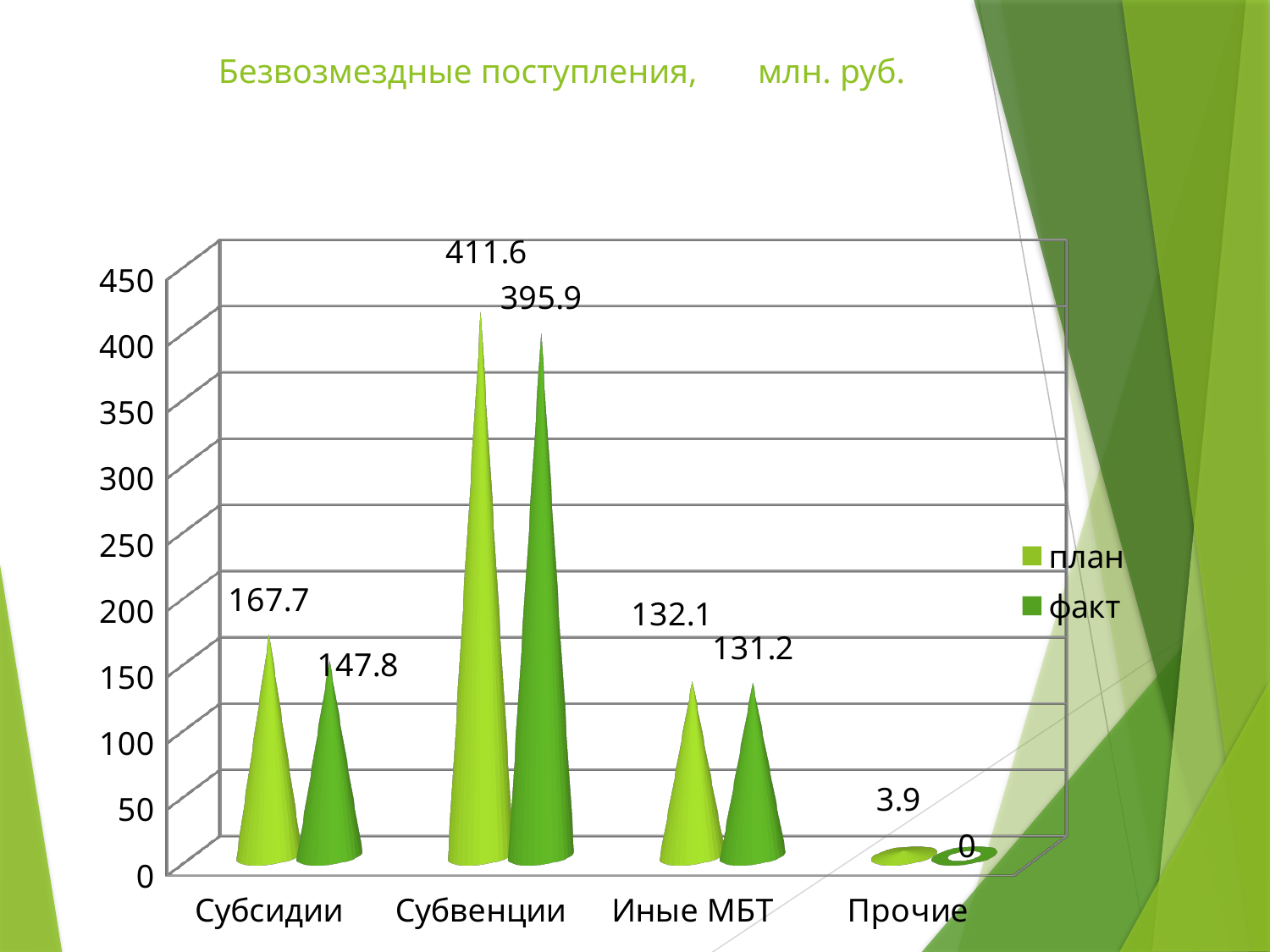
How many series does the legend list? 2 Which category has the lowest план value? Прочие What is the title of the chart? Безвозмездные поступления, млн. руб. Which is larger: the план value for Субсидии or the план value for Иные МБТ? Субсидии What is the факт value for Субсидии? 147.8 What is the difference between the план and факт values for Субвенции? 15.7 What is the план value for Субвенции? 411.6 How many categories are shown on the x axis? 4 What is the план value for Прочие? 3.9 Which category has the highest факт value? Субвенции What is the факт value for Иные МБТ? 131.2 What is the difference between the план and факт values for Субсидии? 19.9